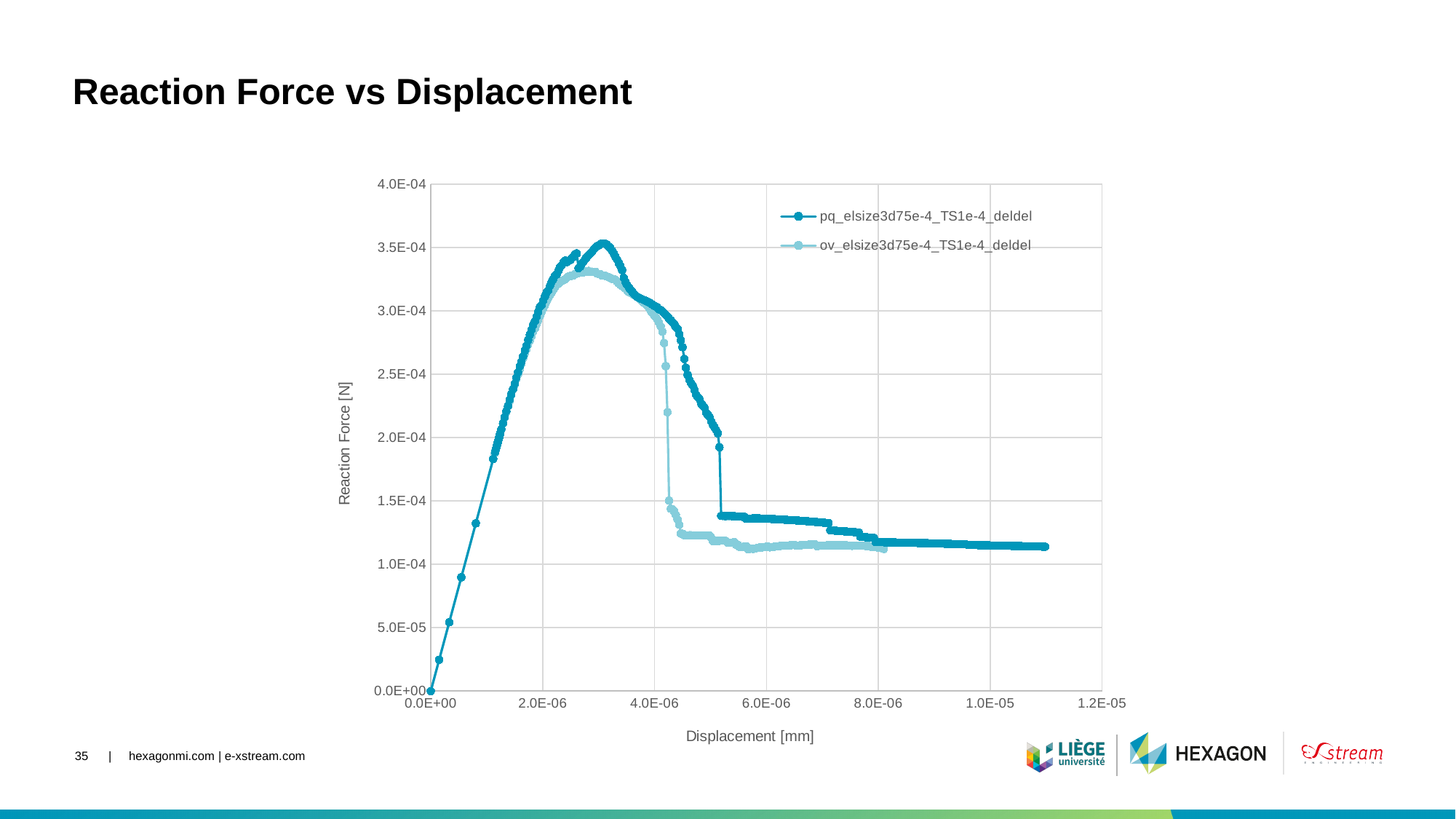
Is the peak value of the ov_elsize3d75e-4_TS1e-4_deldel series greater or less than 4.0E-04? less Does the reaction force of the pq_elsize3d75e-4_TS1e-4_deldel series rise or fall between displacements of 0.0E+00 and 2.0E-06? rise Is the reaction force of the pq_elsize3d75e-4_TS1e-4_deldel series at a displacement of 1.0E-05 greater or less than 1.5E-04? less How many series does the legend list? 2 Which series extends to the larger displacement on the x axis? pq_elsize3d75e-4_TS1e-4_deldel What is the label of the y axis? Reaction Force [N] Which series reaches the higher peak reaction force, pq_elsize3d75e-4_TS1e-4_deldel or ov_elsize3d75e-4_TS1e-4_deldel? pq_elsize3d75e-4_TS1e-4_deldel What is the label of the x axis? Displacement [mm] What kind of chart is shown on the slide? line chart Which series shows its sharp drop in reaction force at the smaller displacement? ov_elsize3d75e-4_TS1e-4_deldel Is the reaction force of the ov_elsize3d75e-4_TS1e-4_deldel series at a displacement of 6.0E-06 greater or less than 1.5E-04? less